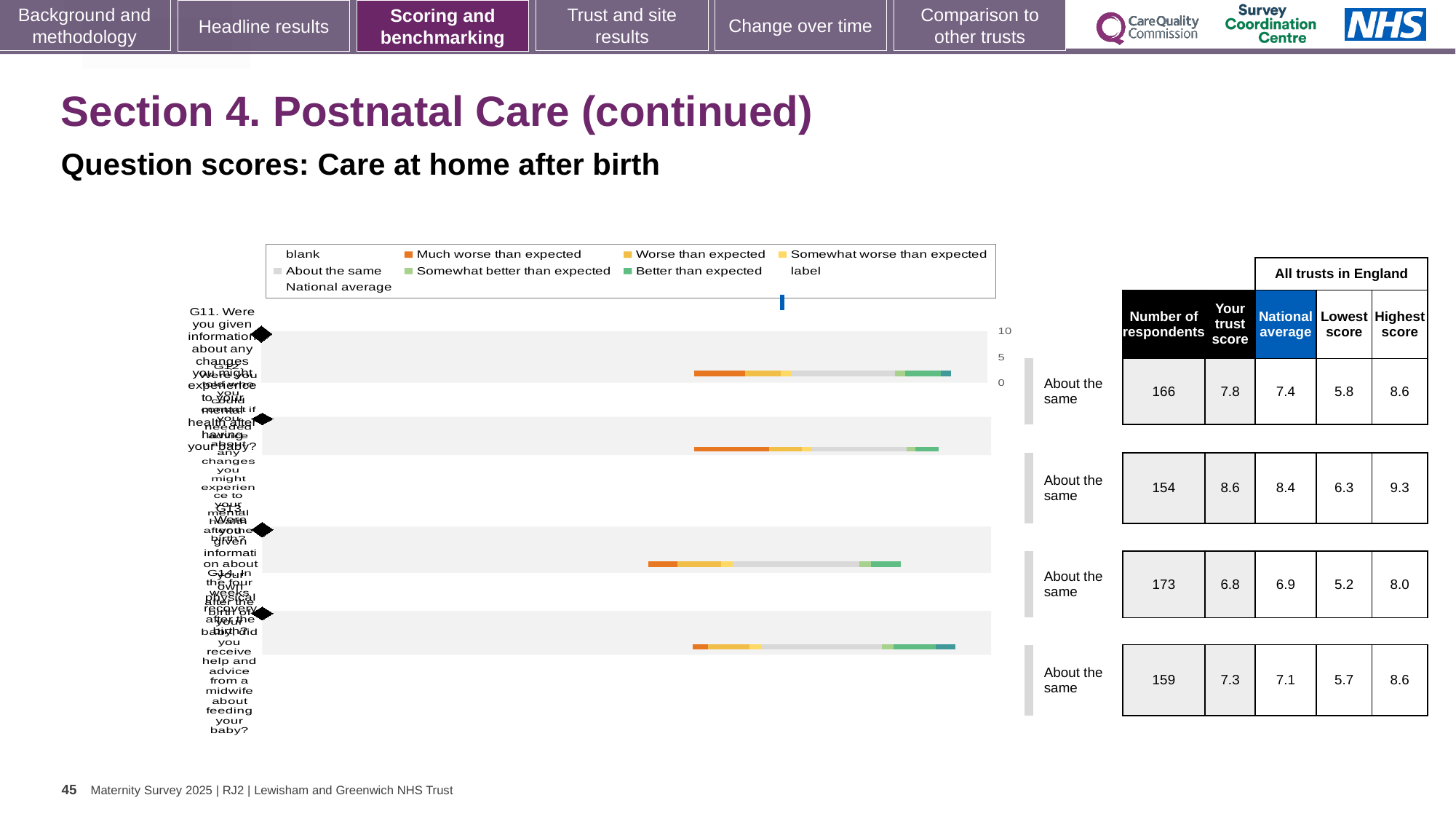
In the table to the right of the chart, is the 'Your trust score' in the third row larger or smaller than the 'National average' in that row? smaller In the table to the right of the chart, which row has the lowest 'Lowest score' value? third row (5.2) How many rows in the table to the right of the chart are labelled 'About the same'? 4 In the table to the right of the chart, what is the number of respondents in the first row? 166 In the table to the right of the chart, which row has the highest 'Highest score' value? second row (9.3) How many horizontal bars are plotted in the chart? 4 In the table to the right of the chart, what is the 'Your trust score' value in the second row? 8.6 In the table to the right of the chart, what is the difference between the 'Your trust score' and the 'National average' in the first row? 0.4 What colour represents 'Much worse than expected' in the chart legend? orange What kind of chart is shown on the slide? bar chart Which legend entry is shown in the lightest grey colour? About the same